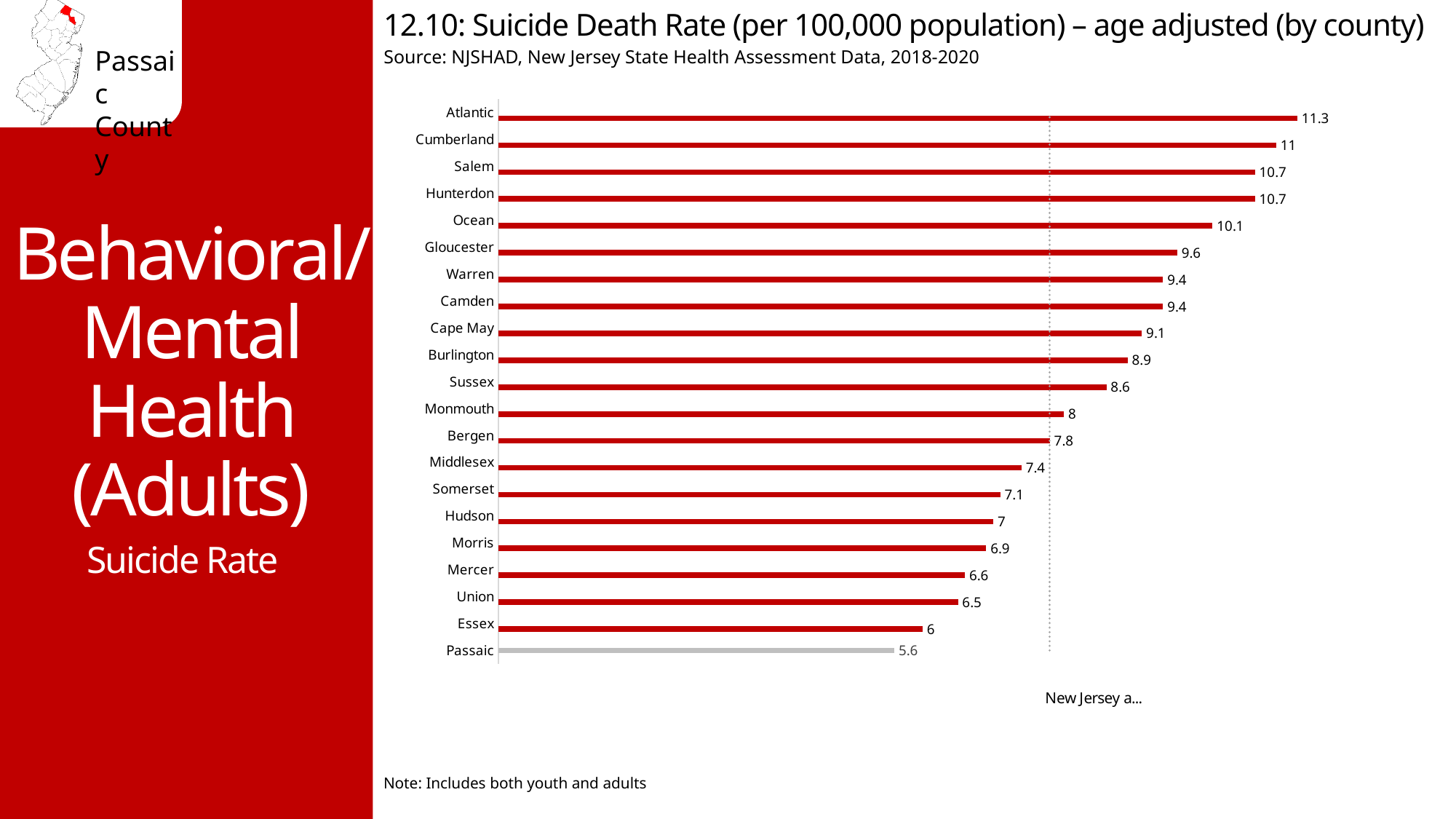
What is the suicide death rate for Ocean County? 10.1 How many counties are shown in the chart? 21 What type of chart is shown on the slide? Bar chart What is the suicide death rate for Passaic County? 5.6 Which county has the lowest suicide death rate? Passaic What is the suicide death rate for Bergen County? 7.8 Which county has the highest suicide death rate? Atlantic What is the difference between the suicide death rates of Atlantic and Passaic counties? 5.7 Which county has a higher suicide death rate, Monmouth or Hudson? Monmouth What is the source of the data shown in the chart? NJSHAD, New Jersey State Health Assessment Data, 2018-2020 What is the difference between the suicide death rates of Gloucester and Sussex counties? 1 Which county has a higher suicide death rate, Cumberland or Essex? Cumberland